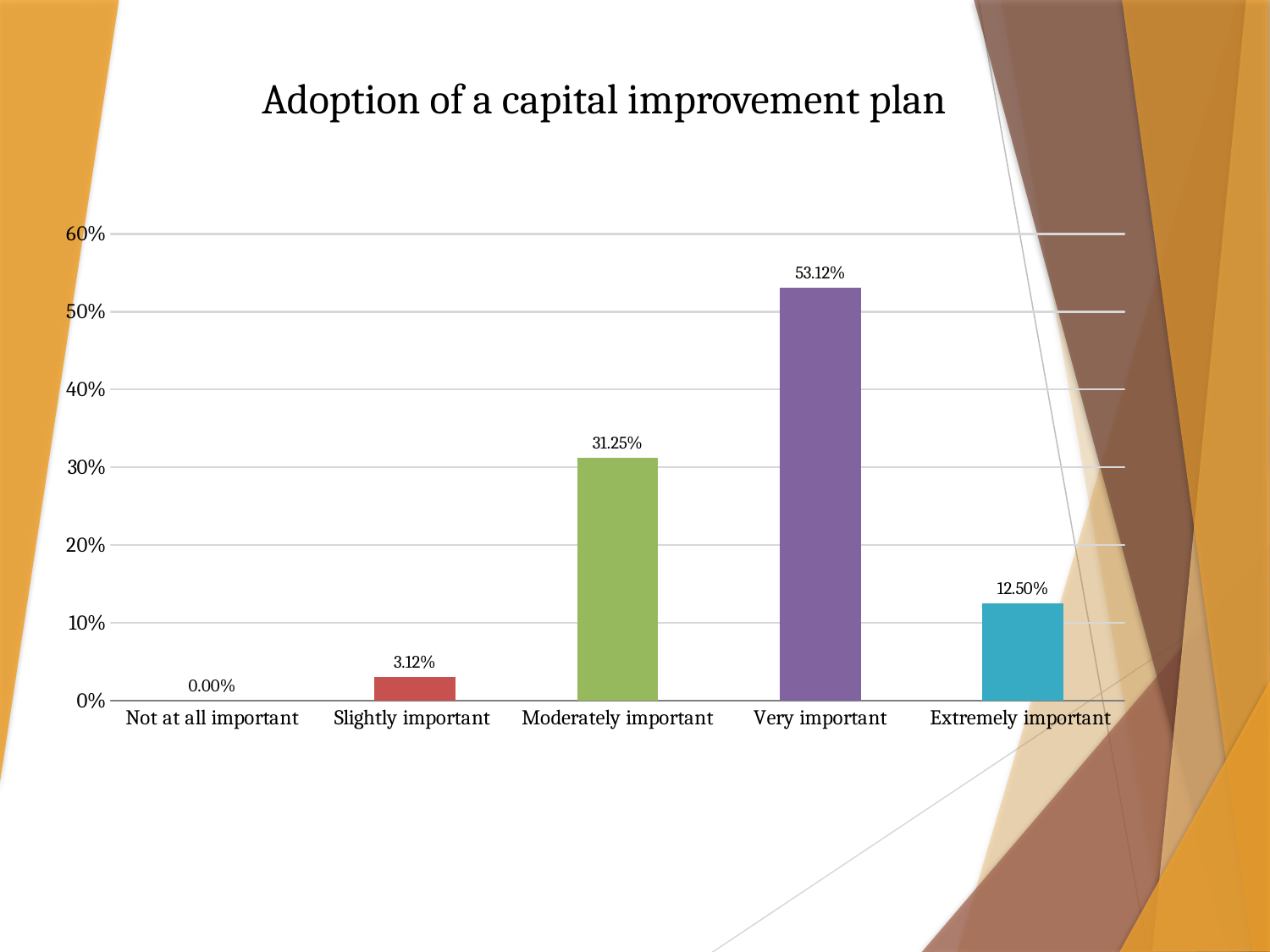
What is the difference between the values for Very important and Moderately important? 21.87% Which category has the highest value? Very important What is the title of the chart? Adoption of a capital improvement plan What kind of chart is shown on the slide? Bar chart What is the value for Slightly important? 3.12% What is the value for Extremely important? 12.50% Which category has the lowest value? Not at all important How many categories are shown on the x axis? 5 Which is larger, the value for Extremely important or the value for Slightly important? Extremely important What is the value for Very important? 53.12% What is the value for Not at all important? 0.00% What is the value for Moderately important? 31.25%